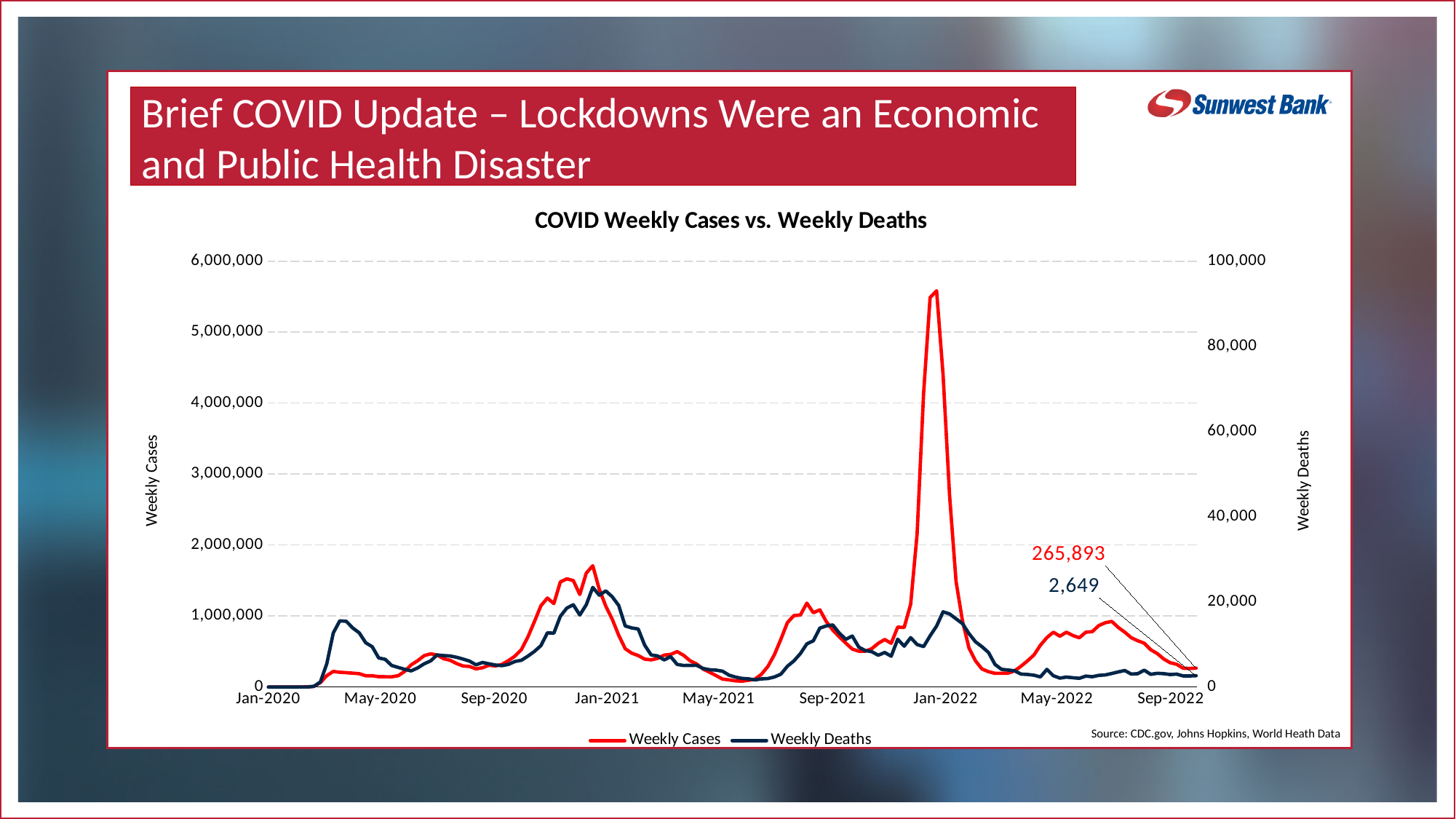
How many series does the legend list? 2 Is the peak value of Weekly Cases around Jan-2022 greater or less than 5,000,000? greater Do Weekly Cases rise or fall between the Jan-2022 peak and May-2022? fall Around which x-axis date do Weekly Cases reach their highest point? Jan-2022 What is the label of the right-hand vertical axis? Weekly Deaths What is the labelled value of Weekly Deaths at the end of the series (Sep-2022)? 2,649 How many date labels are shown on the x axis? 9 Is the value of Weekly Deaths at Sep-2022 greater or less than 20,000? less What is the title of the chart? COVID Weekly Cases vs. Weekly Deaths What is the labelled value of Weekly Cases at the end of the series (Sep-2022)? 265,893 Is the peak value of Weekly Cases around Jan-2021 greater or less than 2,000,000? less What kind of chart is shown on the slide? Line chart